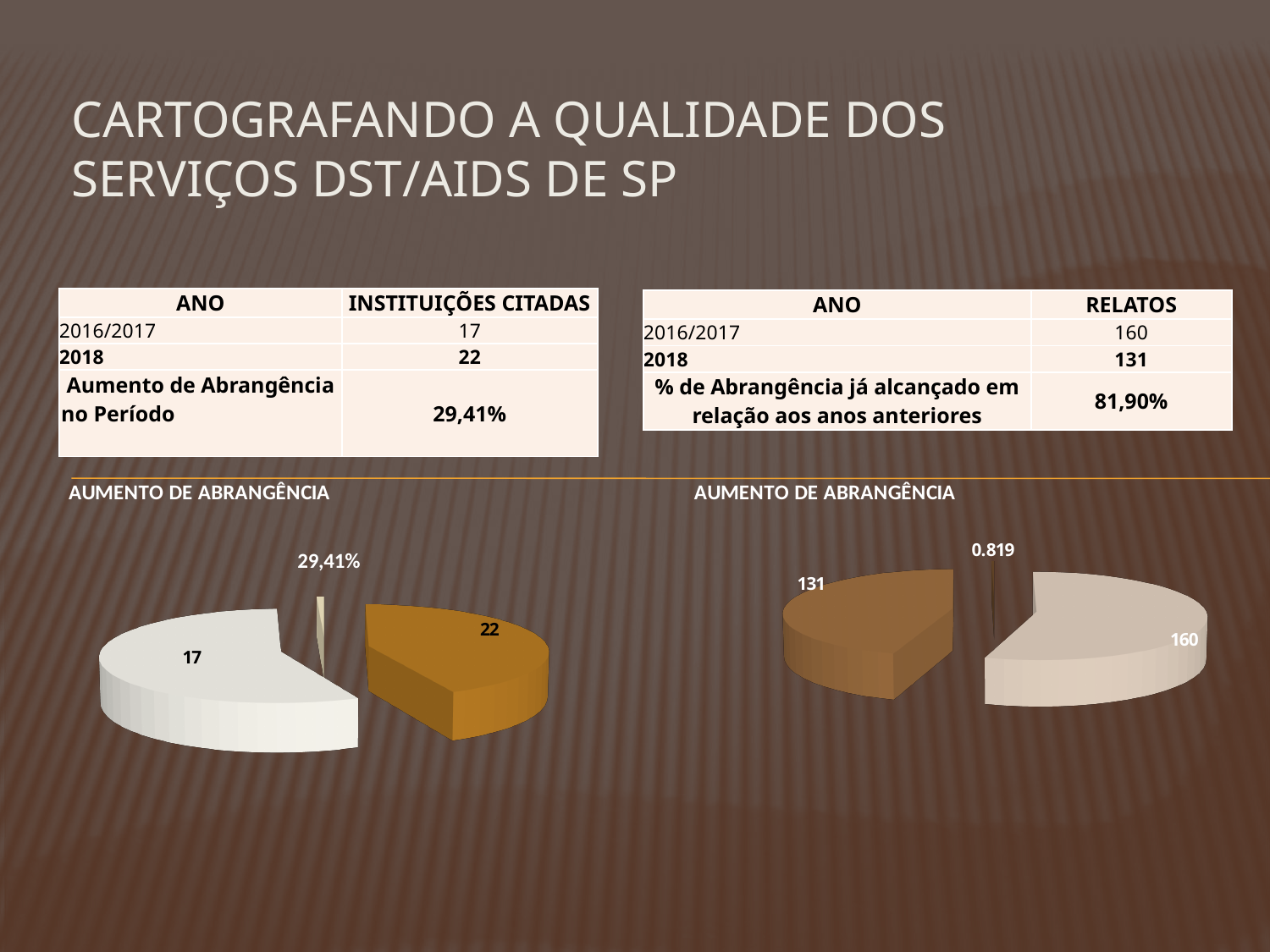
How many slices does the right pie chart have? 3 In the right pie chart, what value is labelled on the dark brown slice? 131 In the left pie chart, which slice has the larger labelled value, the white slice or the orange slice? The orange slice (22) In the left pie chart, what is the difference between the slices labelled 22 and 17? 5 What kind of chart is the right chart titled AUMENTO DE ABRANGÊNCIA? Pie chart How many slices does the left pie chart have? 3 In the right pie chart, what value is labelled on the thin sliver slice? 0.819 In the left pie chart, what value is labelled on the thin sliver slice? 29,41% In the left pie chart, what value is labelled on the white slice? 17 In the right pie chart, which slice has the highest labelled value? 160 In the right pie chart, what is the difference between the slices labelled 160 and 131? 29 What kind of chart is the left chart titled AUMENTO DE ABRANGÊNCIA? Pie chart